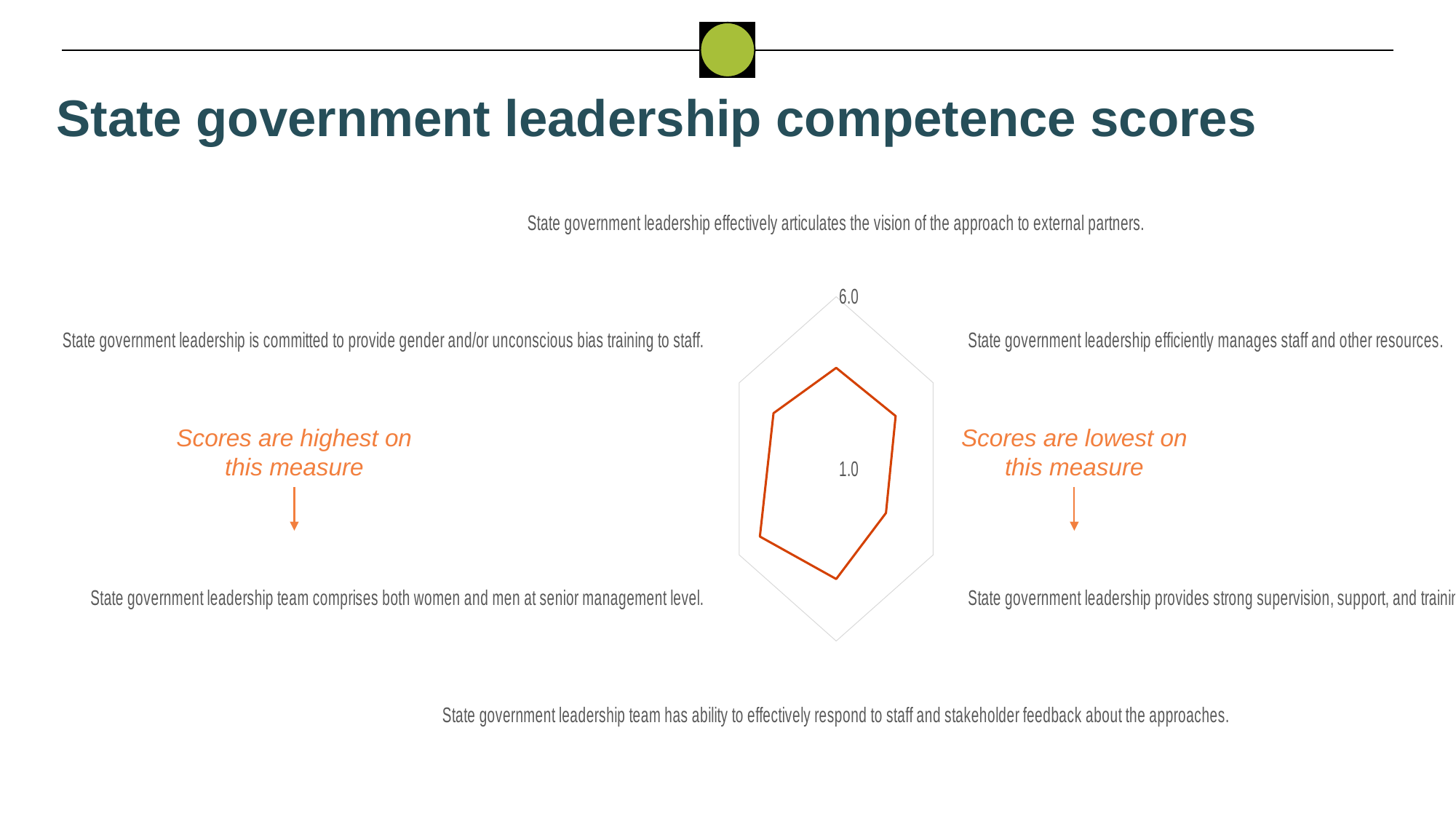
Is the score for 'State government leadership efficiently manages staff and other resources' greater or less than 1.0? greater Is the score for 'State government leadership team has ability to effectively respond to staff and stakeholder feedback about the approaches' greater or less than 6.0? less What is the maximum value shown on the radar chart's axis? 6.0 Is the score for 'State government leadership effectively articulates the vision of the approach to external partners' greater or less than 6.0? less On which measure are the state government leadership competence scores highest? State government leadership team comprises both women and men at senior management level. What kind of chart is shown on the slide? Radar chart Which has the larger score: 'State government leadership team comprises both women and men at senior management level' or 'State government leadership provides strong supervision, support, and training'? State government leadership team comprises both women and men at senior management level How many measures (categories) are plotted on the radar chart? 6 What is the title of the slide containing the radar chart? State government leadership competence scores